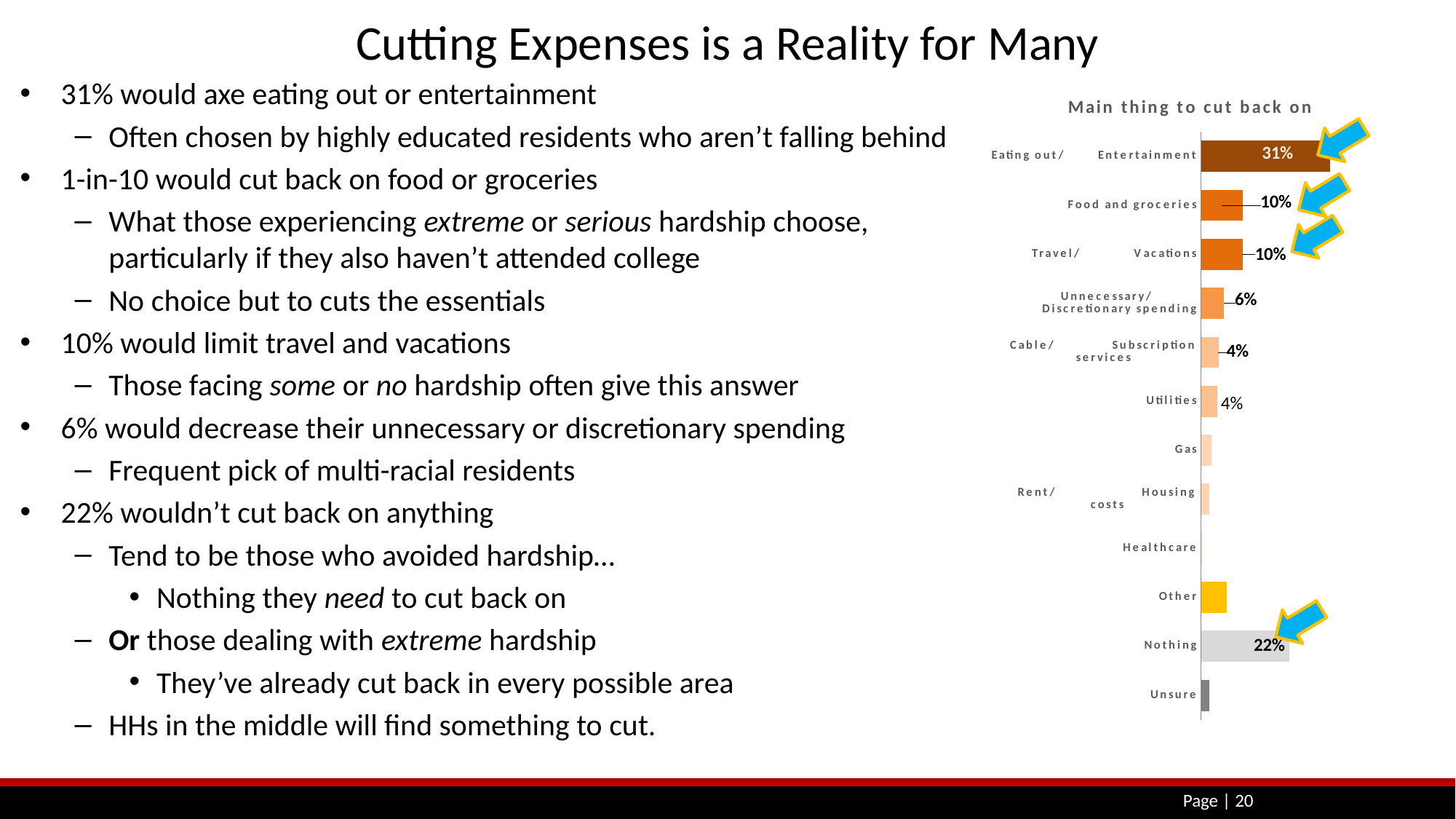
What is the value for Eating out/Entertainment in the chart? 31% What is the value for Nothing in the chart? 22% Which category has the highest value in the chart? Eating out/Entertainment What is the value for Utilities in the chart? 4% What is the value for Food and groceries in the chart? 10% What is the difference between the values for Eating out/Entertainment and Nothing? 9% What is the difference between the values for Food and groceries and Unnecessary/Discretionary spending? 4% Which is larger, the value for Nothing or the value for Travel/Vacations? Nothing How many categories are shown in the chart? 12 What kind of chart is shown on the slide? Bar chart What is the value for Unnecessary/Discretionary spending in the chart? 6% What is the title of the chart? Main thing to cut back on